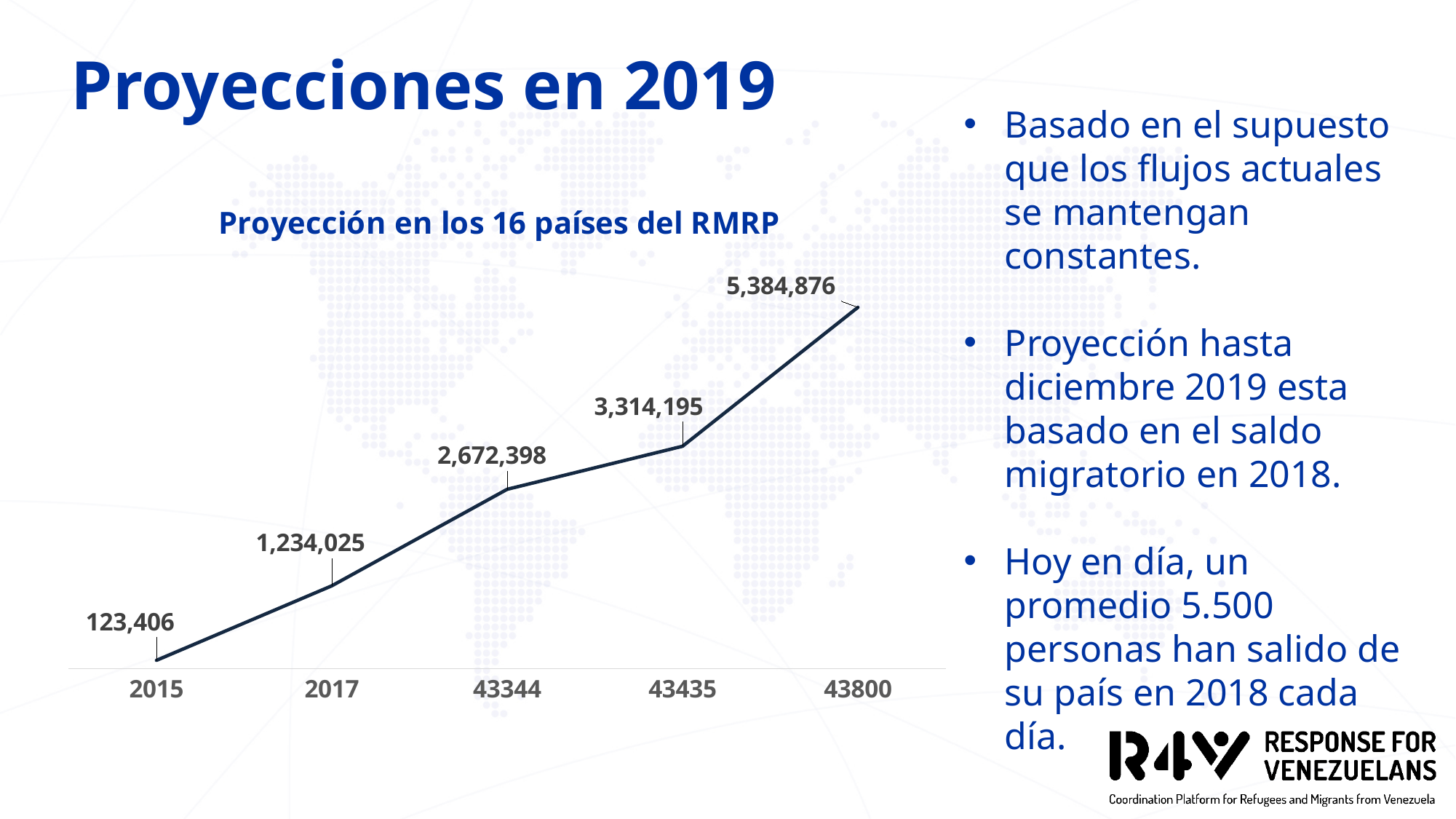
Which category has the lowest value? 2015 Which category has the highest value? 43800 What is the difference between the values for 2017 and 2015? 1,110,619 What is the value for the category labelled 43800? 5,384,876 What kind of chart is shown? Line chart Which is larger, the value for 43344 or the value for 2017? 43344 What is the value for 2015? 123,406 What is the difference between the values for 43800 and 43435? 2,070,681 What is the value for the category labelled 43344? 2,672,398 What is the value for the category labelled 43435? 3,314,195 What is the value for 2017? 1,234,025 How many data points are plotted on the chart? 5